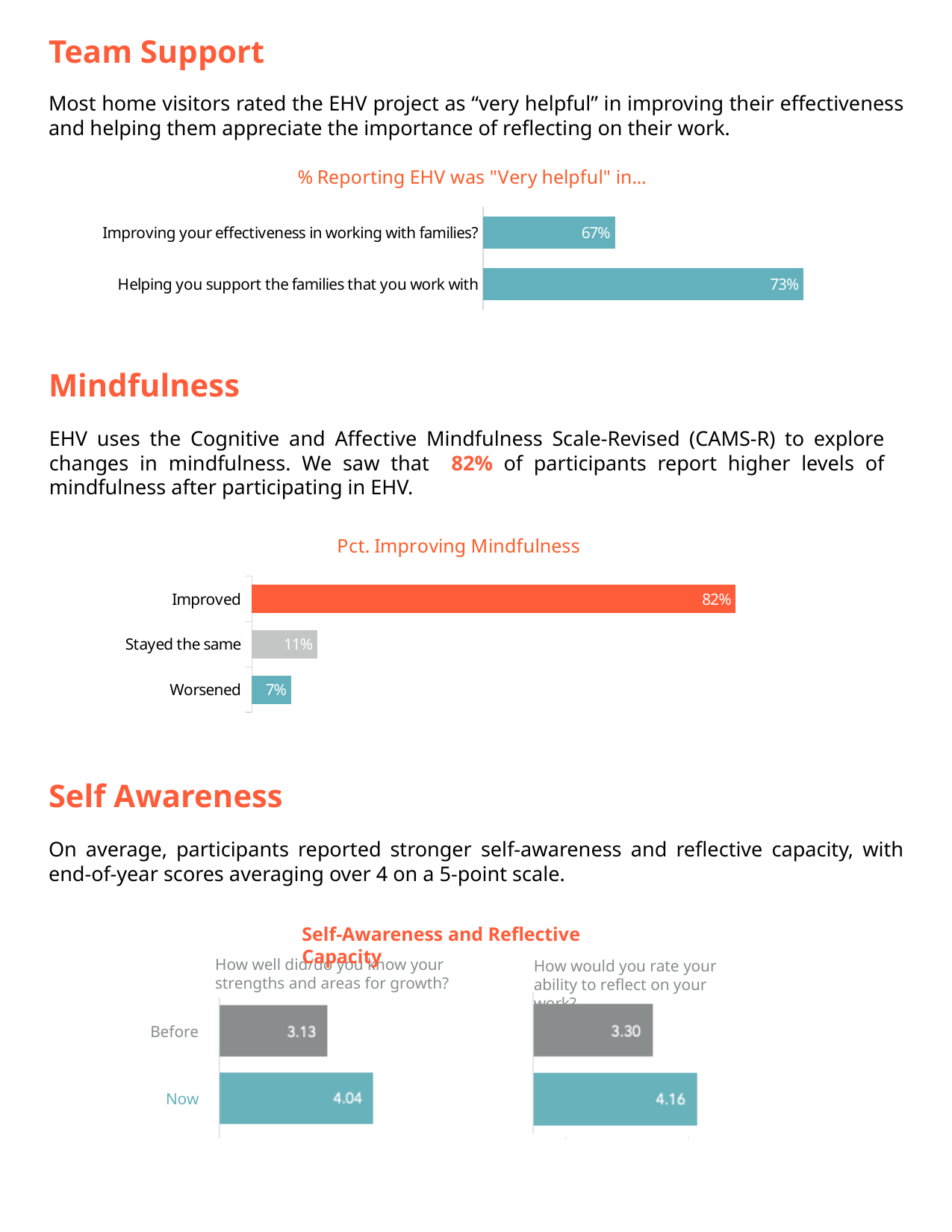
In the "Self-Awareness and Reflective Capacity" chart, what is the "Before" score for "How would you rate your ability to reflect on your work?"? 3.30 In the "% Reporting EHV was 'Very helpful' in…" chart, what percentage is shown for "Helping you support the families that you work with"? 73% What type of chart is the "Pct. Improving Mindfulness" chart? Bar chart In the "Pct. Improving Mindfulness" chart, what percentage is shown for "Stayed the same"? 11% In the "Self-Awareness and Reflective Capacity" chart, what is the "Now" score for "How well did/do you know your strengths and areas for growth?"? 4.04 In the "Pct. Improving Mindfulness" chart, what colour is the "Improved" bar? Orange How many categories are shown in the "Pct. Improving Mindfulness" chart? 3 In the "Pct. Improving Mindfulness" chart, which category has the highest value? Improved In the "% Reporting EHV was 'Very helpful' in…" chart, what is the difference between the two bars? 6% In the "Pct. Improving Mindfulness" chart, which category has the lowest value? Worsened In the "Self-Awareness and Reflective Capacity" chart, what is the difference between the "Now" and "Before" scores for "How well did/do you know your strengths and areas for growth?"? 0.91 In the "% Reporting EHV was 'Very helpful' in…" chart, what percentage is shown for "Improving your effectiveness in working with families?"? 67%